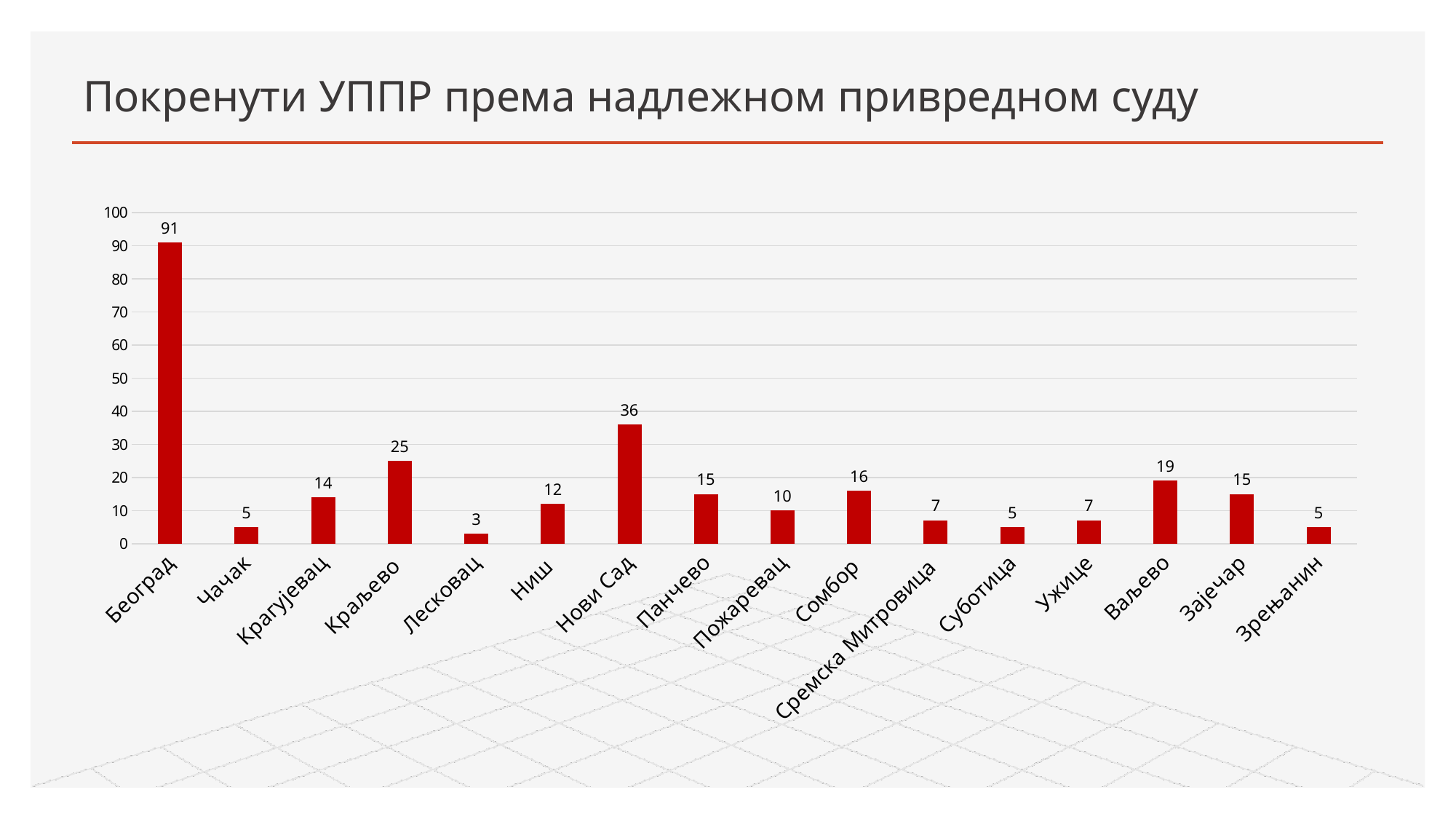
What is the difference between the values for Краљево and Ваљево? 6 Is the value for Краљево greater or less than 20? greater What is the title of the slide? Покренути УППР према надлежном привредном суду Which category has the highest value? Београд Which is larger, the value for Сомбор or the value for Пожаревац? Сомбор What is the value for Београд? 91 What is the value for Нови Сад? 36 What is the difference between the values for Београд and Нови Сад? 55 Which category has the lowest value? Лесковац What kind of chart is shown on the slide? bar chart What is the value for Сремска Митровица? 7 How many categories are shown on the x axis? 16